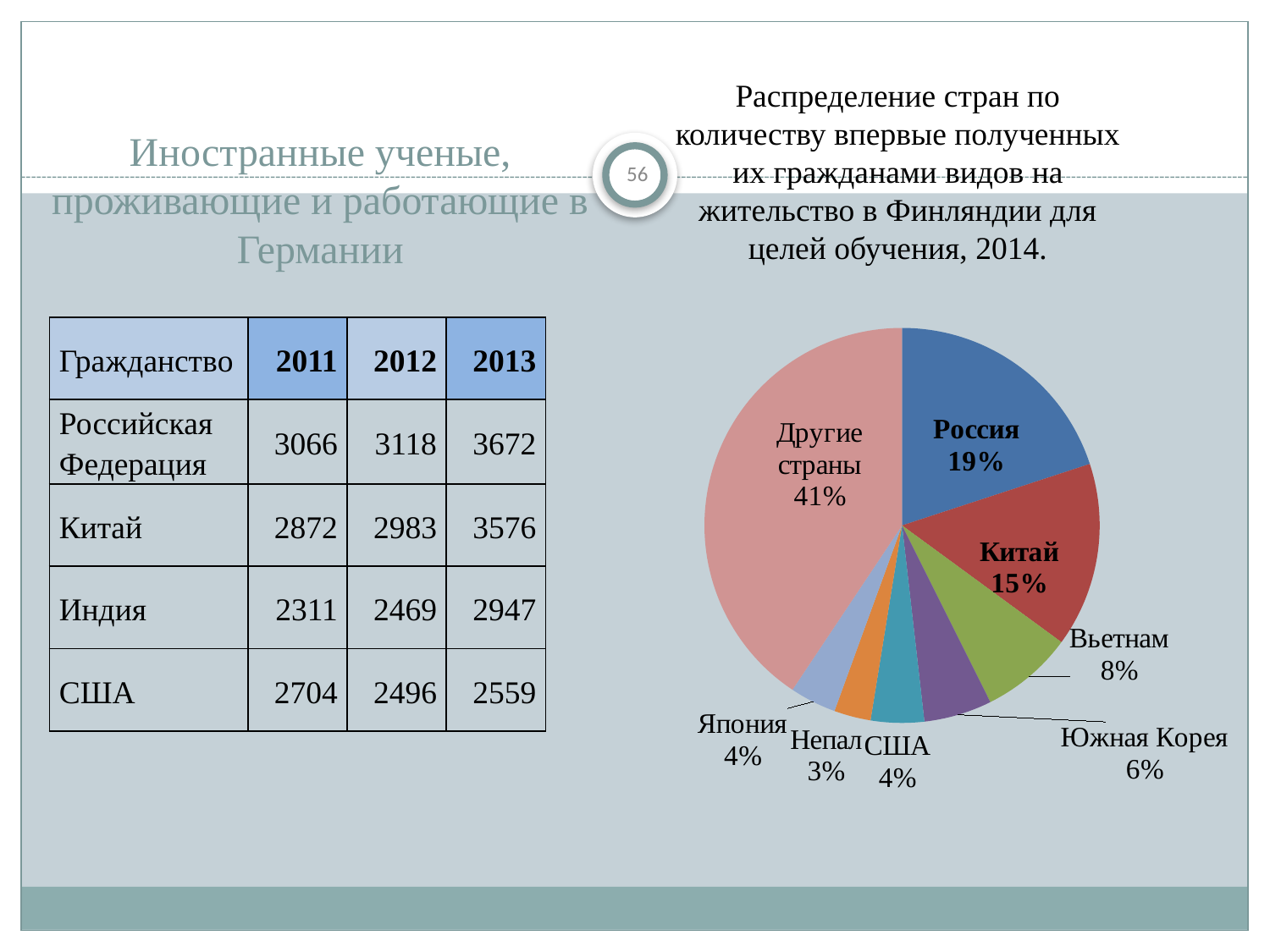
In the pie chart, what share is shown for Россия? 19% In the pie chart, which slice is the smallest? Непал In the pie chart, which is larger: the share for Вьетнам or the share for Южная Корея? Вьетнам In the pie chart, what is the difference in percentage points between Россия and Китай? 4 In the pie chart, what share is shown for Непал? 3% In the pie chart, which slice is the largest? Другие страны In the pie chart, what share is shown for Вьетнам? 8% In the pie chart, how many slices are there? 8 In the pie chart, what share is shown for Китай? 15% In the pie chart, what share is shown for Южная Корея? 6% What type of chart is shown on the right side of the slide? pie chart What year is mentioned in the title of the pie chart? 2014